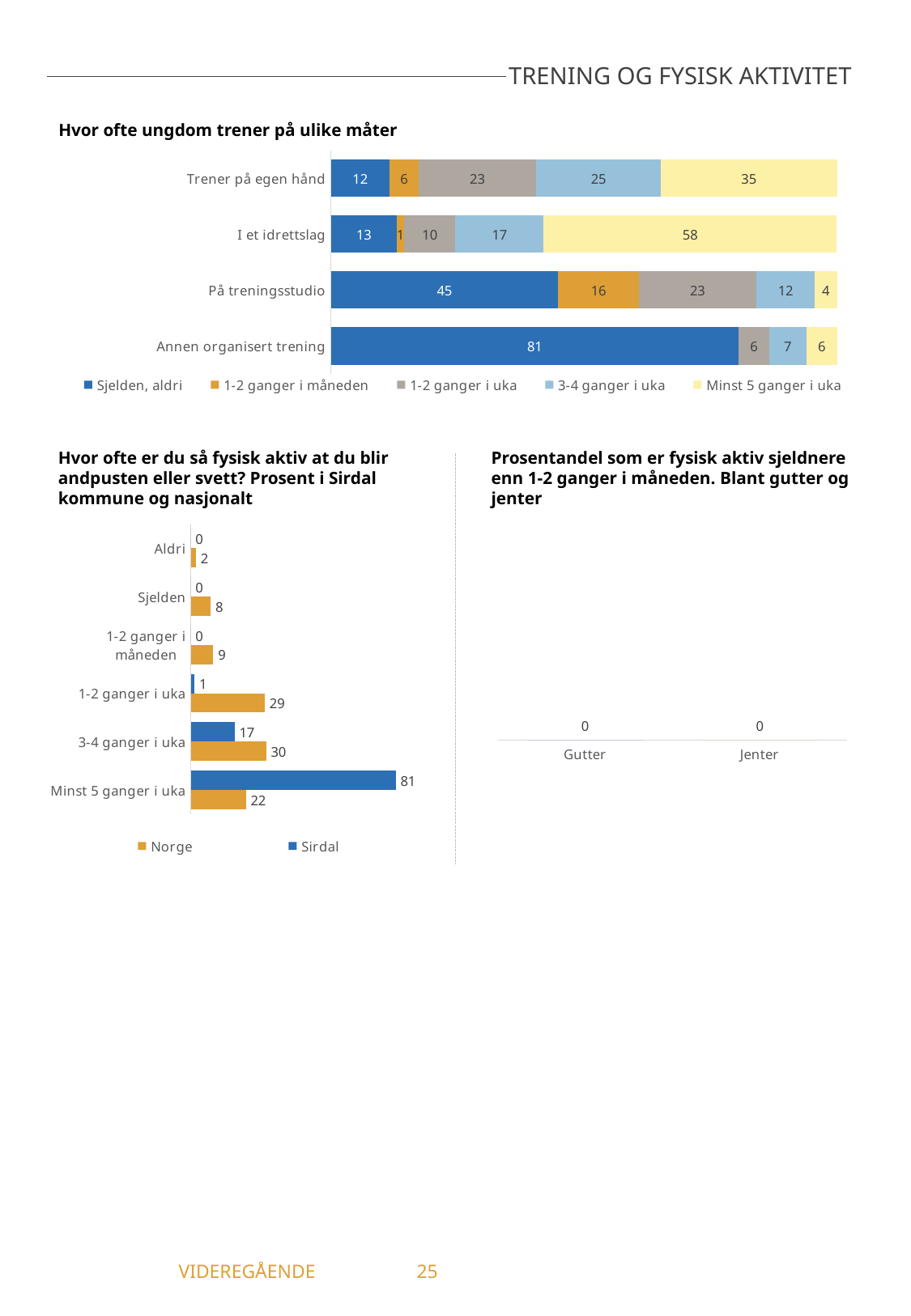
In the chart 'Hvor ofte er du så fysisk aktiv at du blir andpusten eller svett?', how many categories are shown? 6 In the chart 'Hvor ofte er du så fysisk aktiv at du blir andpusten eller svett?', which is larger for '3-4 ganger i uka', Norge or Sirdal? Norge In the chart 'Hvor ofte ungdom trener på ulike måter', what is the total of the stacked bar for 'På treningsstudio'? 100 In the chart 'Hvor ofte ungdom trener på ulike måter', what is the difference between the 'Minst 5 ganger i uka' values for 'Trener på egen hånd' and 'På treningsstudio'? 31 In the chart 'Hvor ofte ungdom trener på ulike måter', what is the value for 'Minst 5 ganger i uka' for 'I et idrettslag'? 58 In the chart 'Hvor ofte ungdom trener på ulike måter', which category has the highest value for 'Sjelden, aldri'? Annen organisert trening In the chart 'Hvor ofte ungdom trener på ulike måter', what is the value for 'Sjelden, aldri' for 'Annen organisert trening'? 81 In the chart 'Hvor ofte er du så fysisk aktiv at du blir andpusten eller svett?', what is the value for Norge for '1-2 ganger i uka'? 29 In the chart 'Hvor ofte er du så fysisk aktiv at du blir andpusten eller svett?', what is the value for Sirdal for 'Minst 5 ganger i uka'? 81 What kind of chart is 'Hvor ofte er du så fysisk aktiv at du blir andpusten eller svett?'? Bar chart In the chart 'Hvor ofte ungdom trener på ulike måter', how many series does the legend list? 5 In the chart 'Prosentandel som er fysisk aktiv sjeldnere enn 1-2 ganger i måneden', what is the value for Jenter? 0